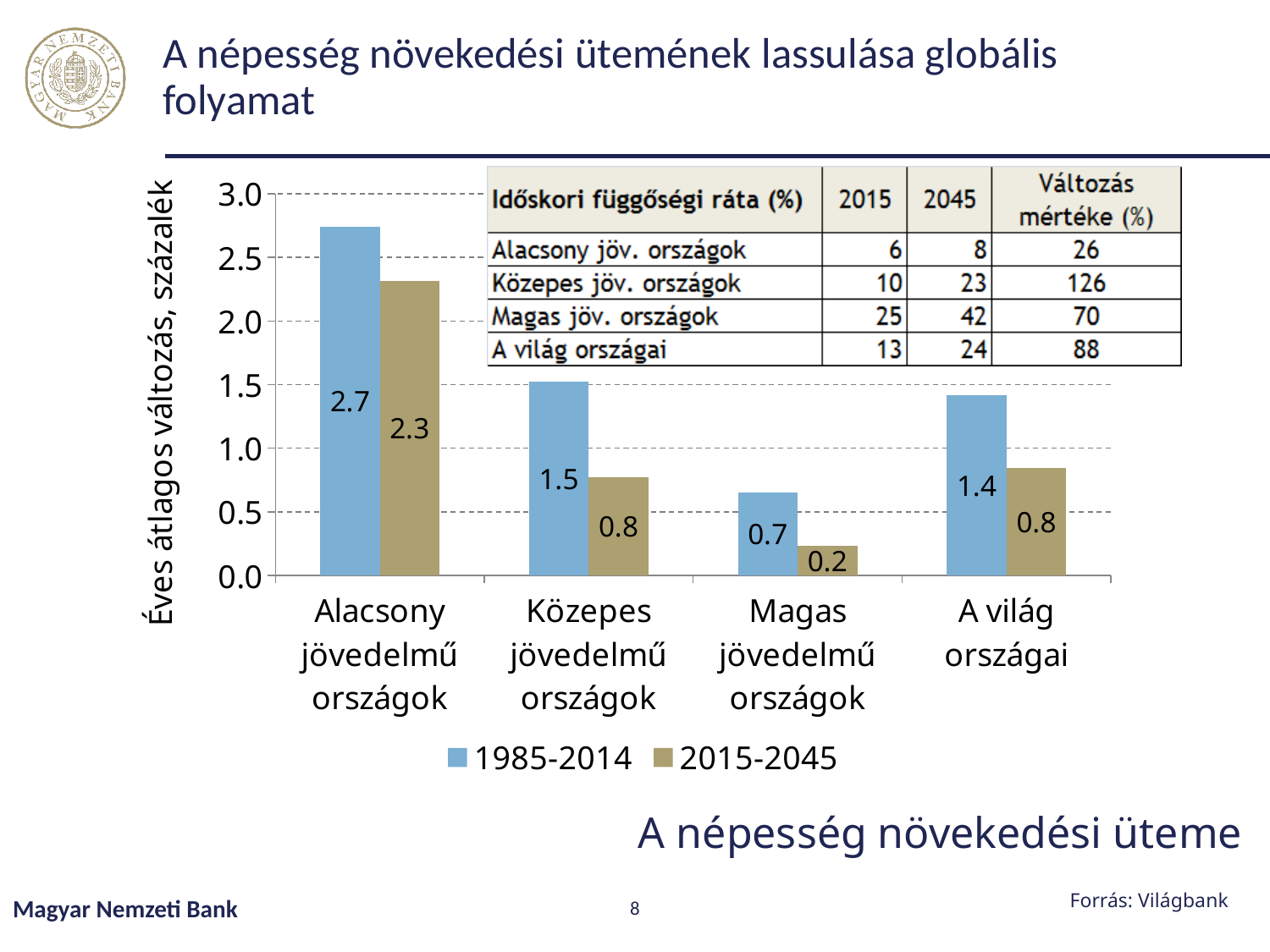
Does the 1985-2014 series rise or fall from Alacsony jövedelmű országok to Magas jövedelmű országok? fall How many categories are shown on the x axis of the chart? 4 What is the difference between the 1985-2014 and 2015-2045 values for Közepes jövedelmű országok? 0.7 Which category has the highest value in the 2015-2045 series? Alacsony jövedelmű országok How many series does the legend list? 2 What is the label of the vertical axis of the chart? Éves átlagos változás, százalék What kind of chart is shown on the slide? bar chart Which is larger for A világ országai: the 1985-2014 value or the 2015-2045 value? 1985-2014 What is the value for Alacsony jövedelmű országok in the 1985-2014 series? 2.7 What is the value for Magas jövedelmű országok in the 2015-2045 series? 0.2 Which category has the lowest value in the 1985-2014 series? Magas jövedelmű országok What is the value for A világ országai in the 1985-2014 series? 1.4